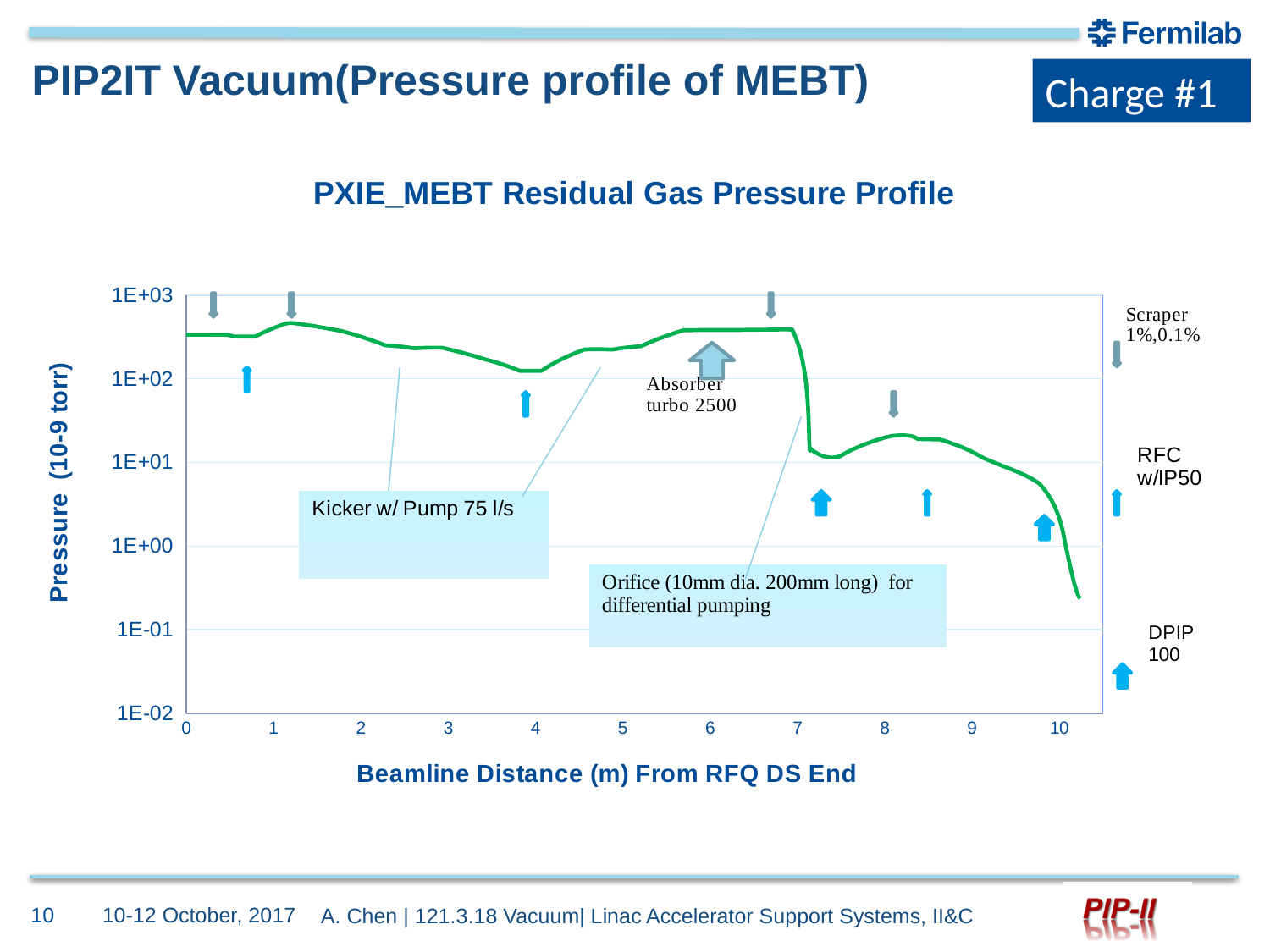
Is the pressure at a beamline distance of 8 m greater or less than 1E+01? greater Is the pressure at a beamline distance of 8 m greater or less than 1E+02? less Overall, does the pressure rise or fall as beamline distance increases from 0 m to 10 m? fall Is the pressure at 2 m larger or smaller than the pressure at 9 m? larger How many data series are plotted in the chart? 1 Is the pressure at a beamline distance of 6 m greater or less than 1E+02? greater Between about 6.5 m and 7.5 m, does the pressure rise or fall? fall What kind of chart is shown on the slide? line chart What is the title of the chart? PXIE_MEBT Residual Gas Pressure Profile What is the label of the x axis of the chart? Beamline Distance (m) From RFQ DS End